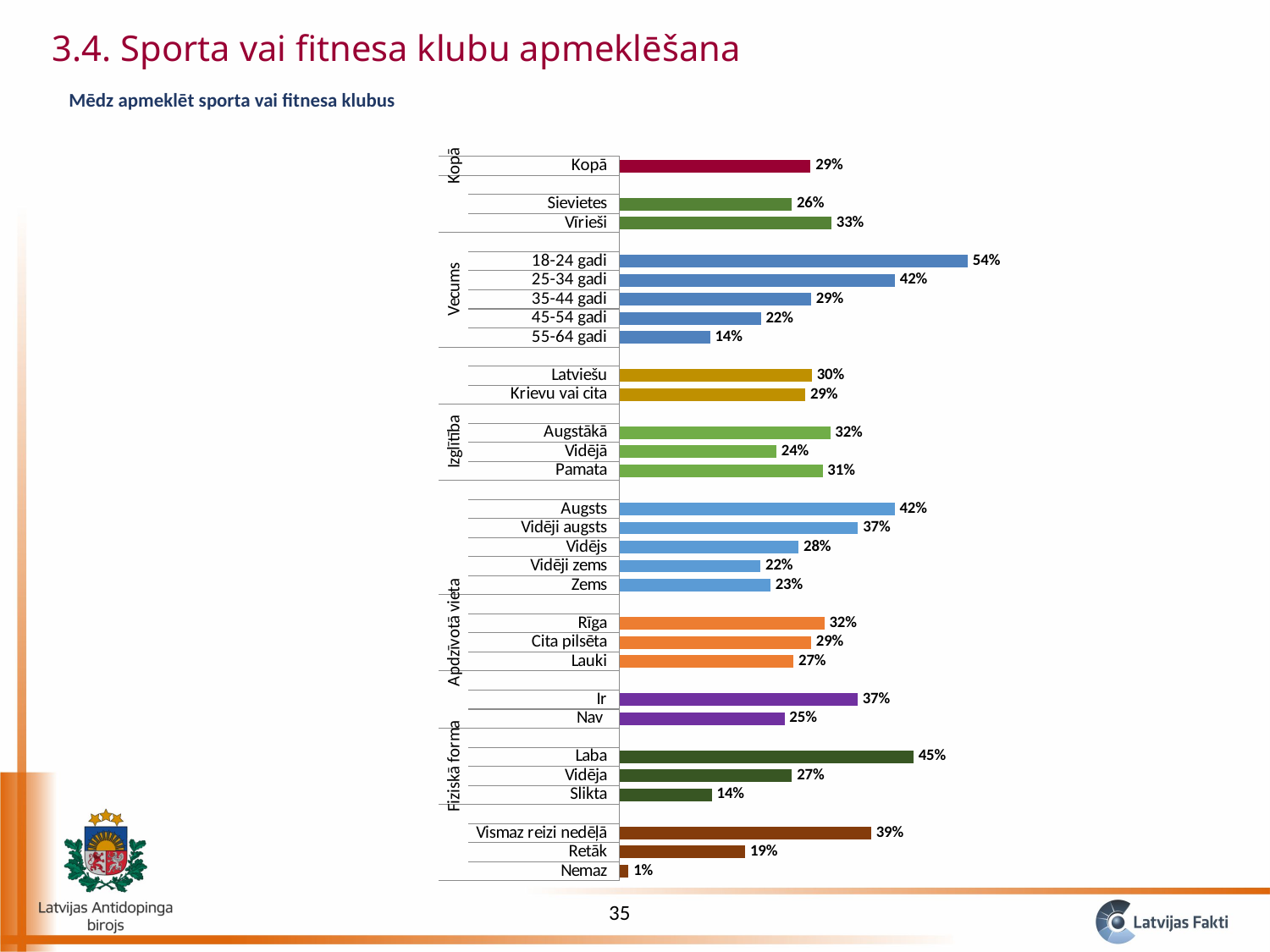
What kind of chart is shown on the slide? Bar chart Which is larger, the value for Rīga or the value for Lauki? Rīga What is the value for Kopā? 29% Which category has the highest value in the chart? 18-24 gadi What is the difference between the values for Vīrieši and Sievietes? 7% Which category has the lowest value in the chart? Nemaz What is the value for the 18-24 gadi age group? 54% What is the value for Laba in the Fiziskā forma group? 45% What is the value for Nemaz? 1% What is the difference between the values for Vismaz reizi nedēļā and Retāk? 20% Do the values rise or fall going from 18-24 gadi down to 55-64 gadi? Fall How many bars are plotted in the chart? 29